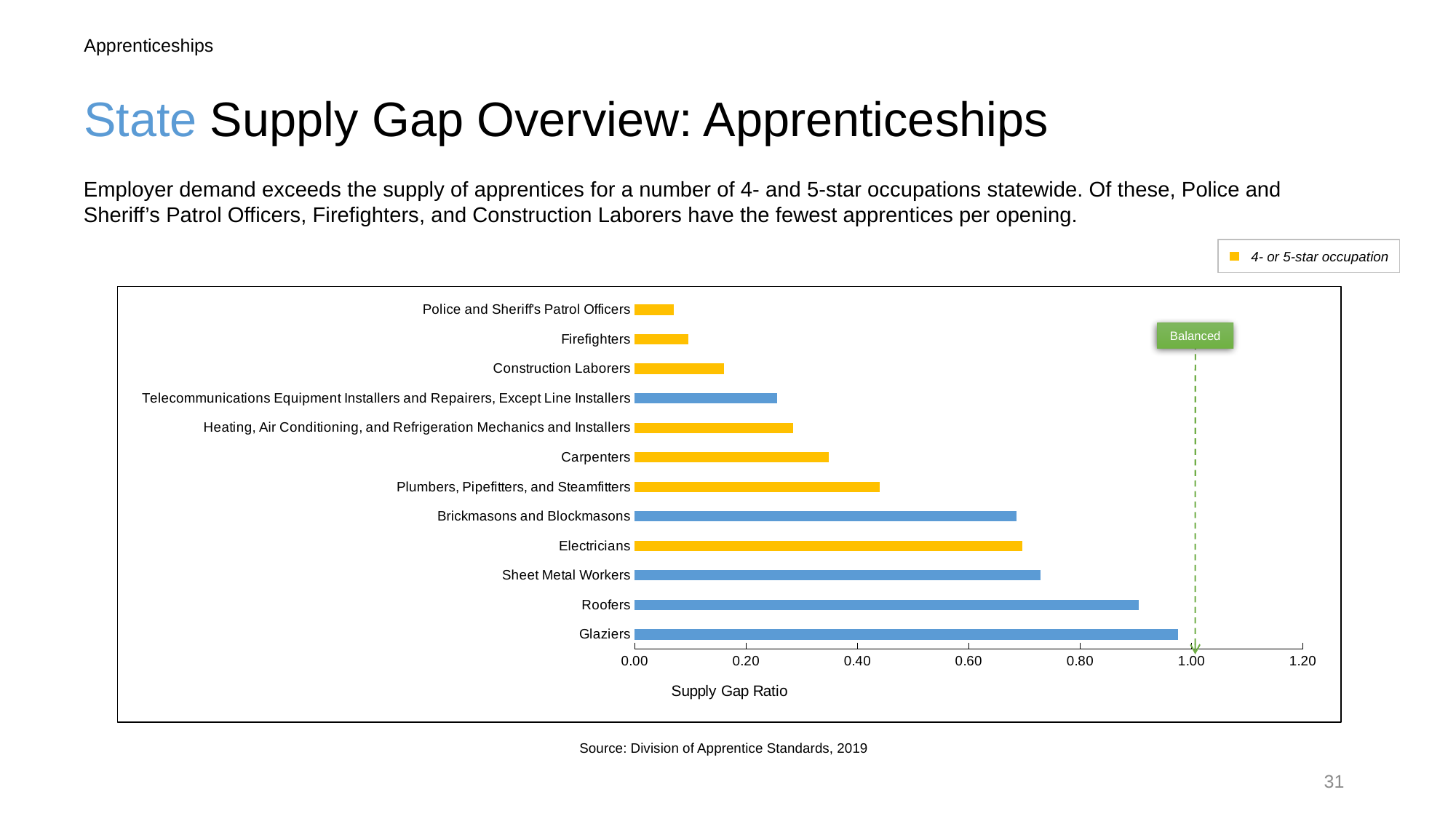
What is the title of the x axis of the chart? Supply Gap Ratio Is the supply gap ratio for Roofers greater or less than 0.80? greater Is the supply gap ratio for Carpenters greater or less than 0.40? less Is the supply gap ratio for Glaziers greater or less than 1.00? less What kind of chart is shown on the slide? bar chart Which occupation has the highest supply gap ratio? Glaziers At what x-axis value is the dashed 'Balanced' line drawn? 1.00 How many occupations are plotted in the chart? 12 Which has a larger supply gap ratio, Carpenters or Plumbers, Pipefitters, and Steamfitters? Plumbers, Pipefitters, and Steamfitters Which occupation has the lowest supply gap ratio? Police and Sheriff's Patrol Officers Which has a larger supply gap ratio, Roofers or Sheet Metal Workers? Roofers